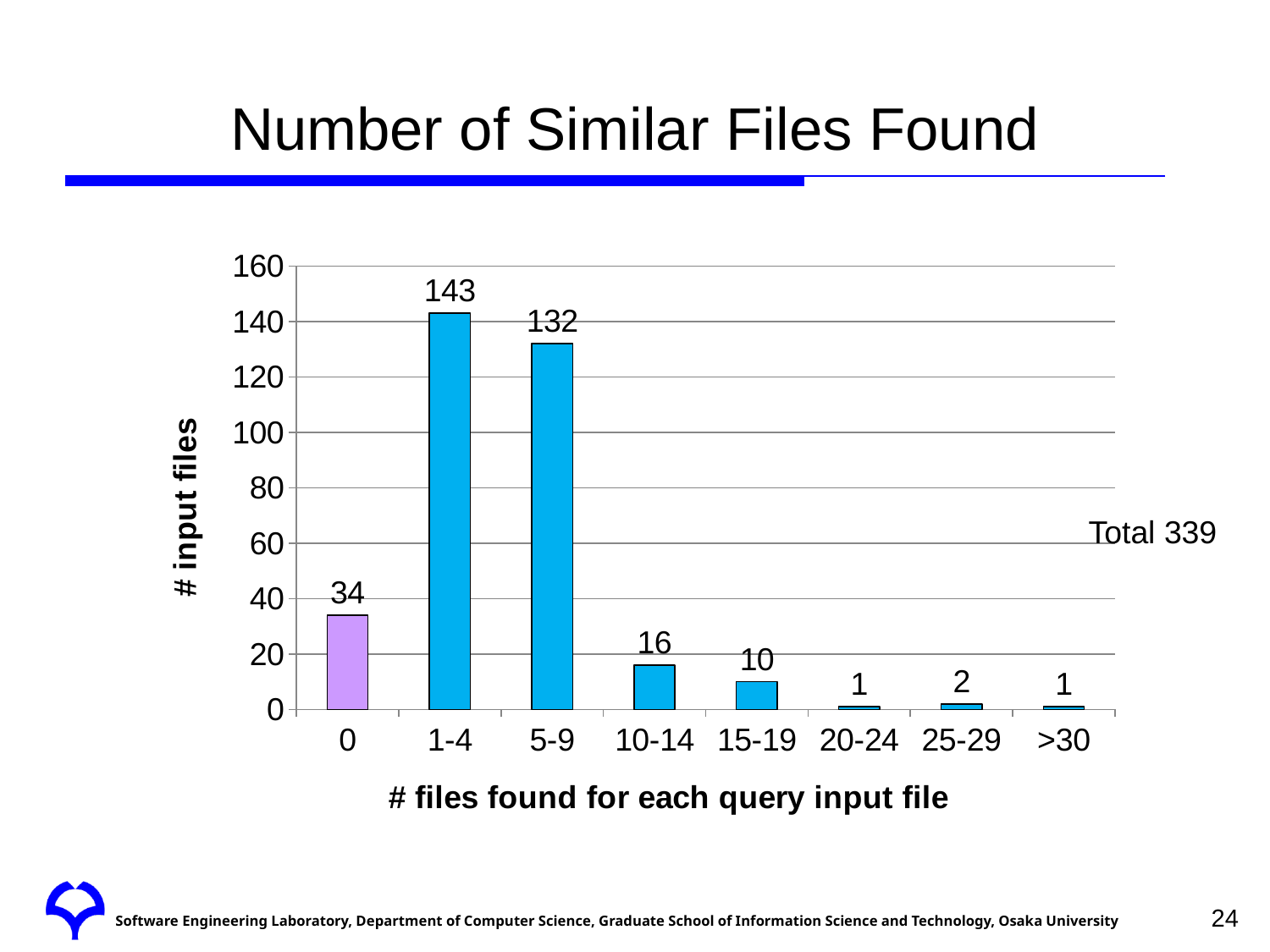
What is the number of input files for the 1-4 category? 143 Which is larger, the value for 10-14 or the value for 15-19? 10-14 Which category has the highest number of input files? 1-4 How many input files had 0 similar files found? 34 What is the value for the 15-19 category? 10 What is the number of input files for the 5-9 category? 132 What kind of chart is shown on the slide? bar chart What total is printed next to the chart? Total 339 What is the difference between the values for the 0 and 10-14 categories? 18 What is the difference between the values for the 1-4 and 5-9 categories? 11 How many categories are shown on the x axis? 8 What is the label of the y axis? # input files